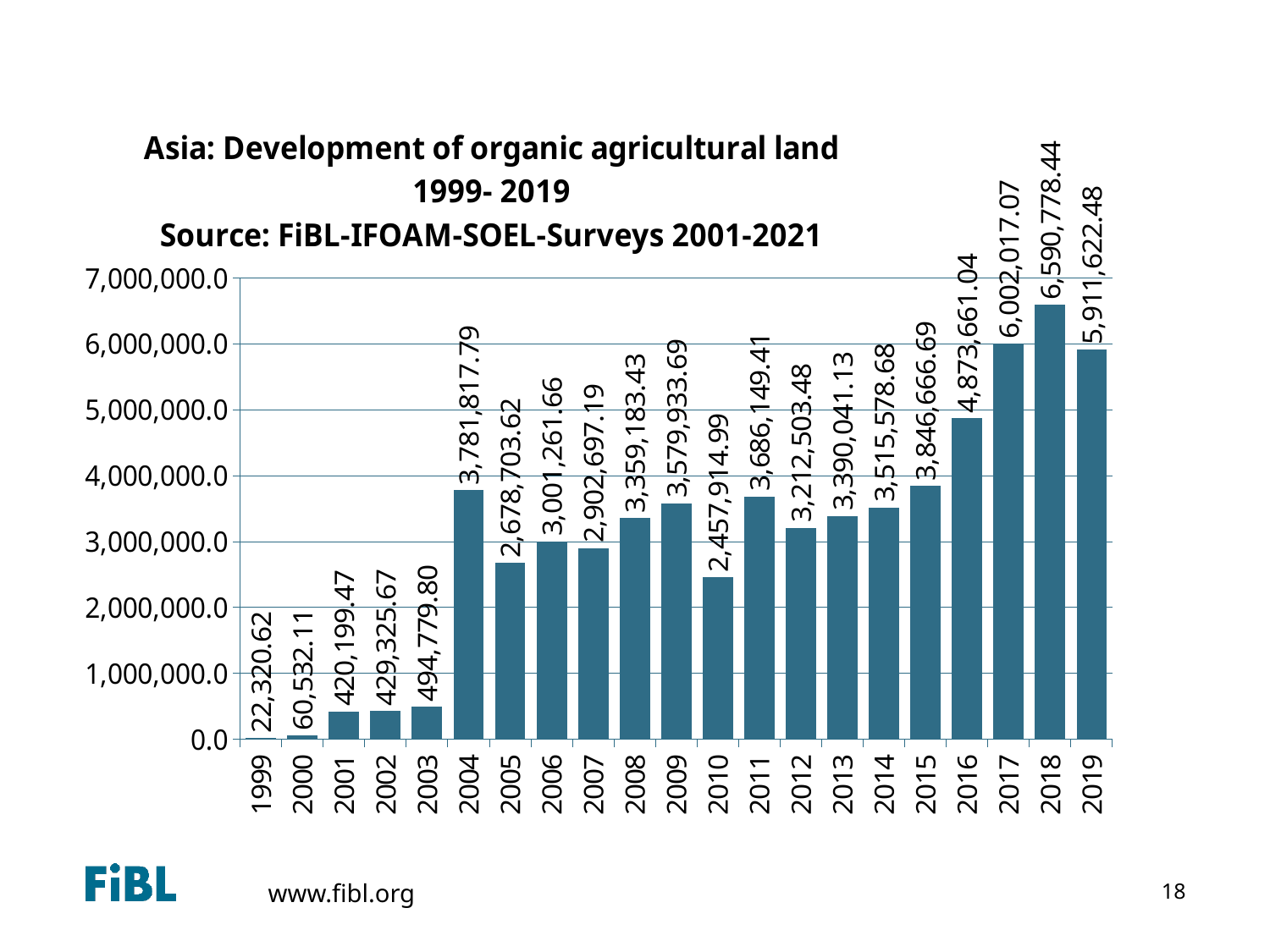
Which year has the highest value? 2018 How many years are shown on the x axis? 21 What is the difference between the values for 2018 and 2019? 679,155.96 What is the value for 1999? 22,320.62 Which is larger, the value for 2009 or the value for 2012? 2009 What kind of chart is this? bar chart Is the value for 2016 greater or less than 5,000,000.0? less What is the value for 2010? 2,457,914.99 What is the difference between the values for 2017 and 2016? 1,128,356.03 What is the value for 2018? 6,590,778.44 What is the value for 2004? 3,781,817.79 Which year has the lowest value? 1999